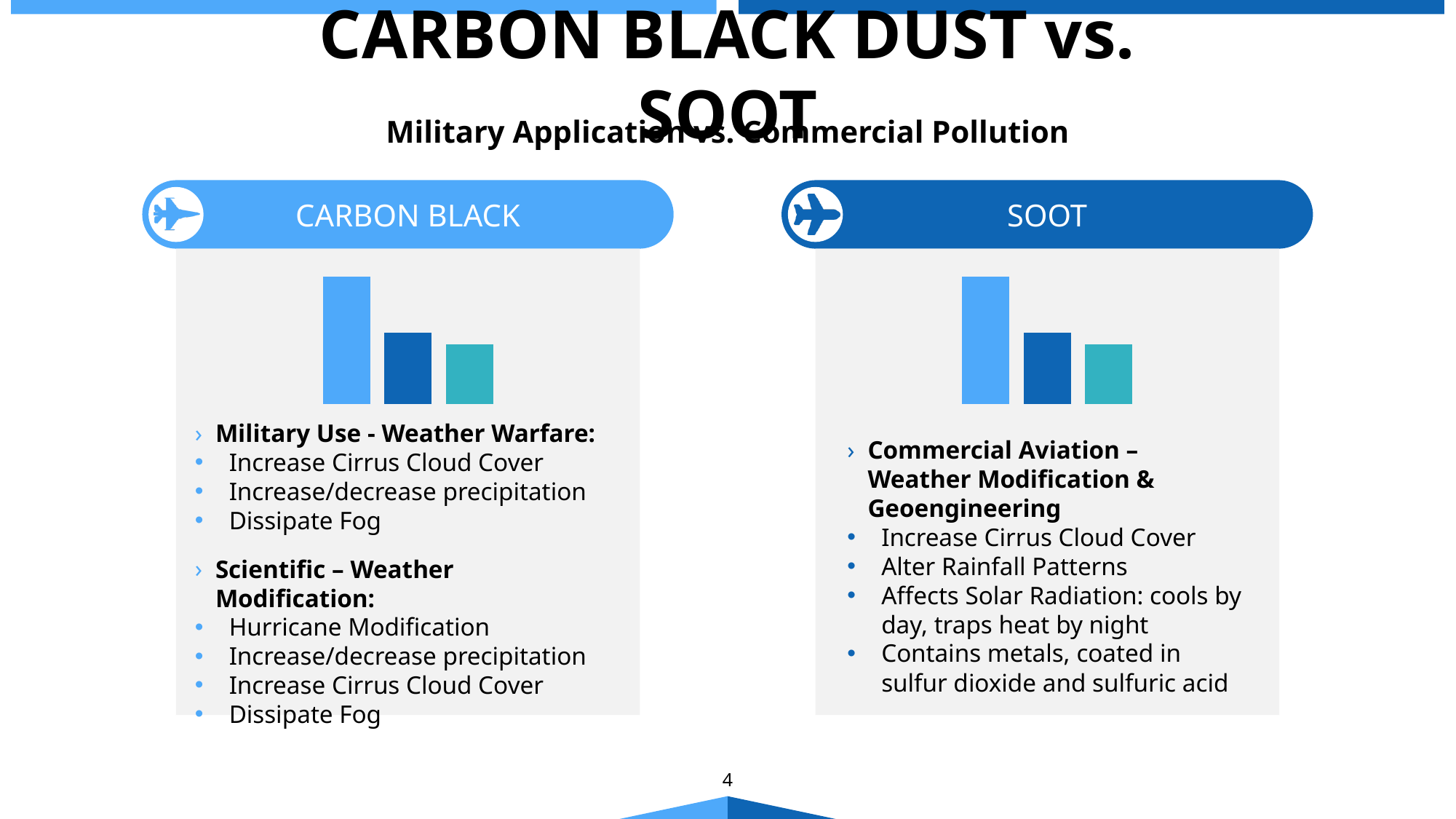
In the CARBON BLACK chart, do the bars rise or fall from left to right? fall In the SOOT chart, which is taller, the middle bar or the rightmost bar? the middle bar In the SOOT chart, what colour is the shortest bar? teal In the CARBON BLACK chart, what colour is the tallest bar? light blue What kind of chart is shown in the CARBON BLACK panel on the left? bar chart In the CARBON BLACK chart, which is taller, the leftmost bar or the rightmost bar? the leftmost bar In the SOOT chart, do the bars rise or fall from left to right? fall How many bars are in the chart in the CARBON BLACK panel? 3 How many bars are in the chart in the SOOT panel? 3 What kind of chart is shown in the SOOT panel on the right? bar chart